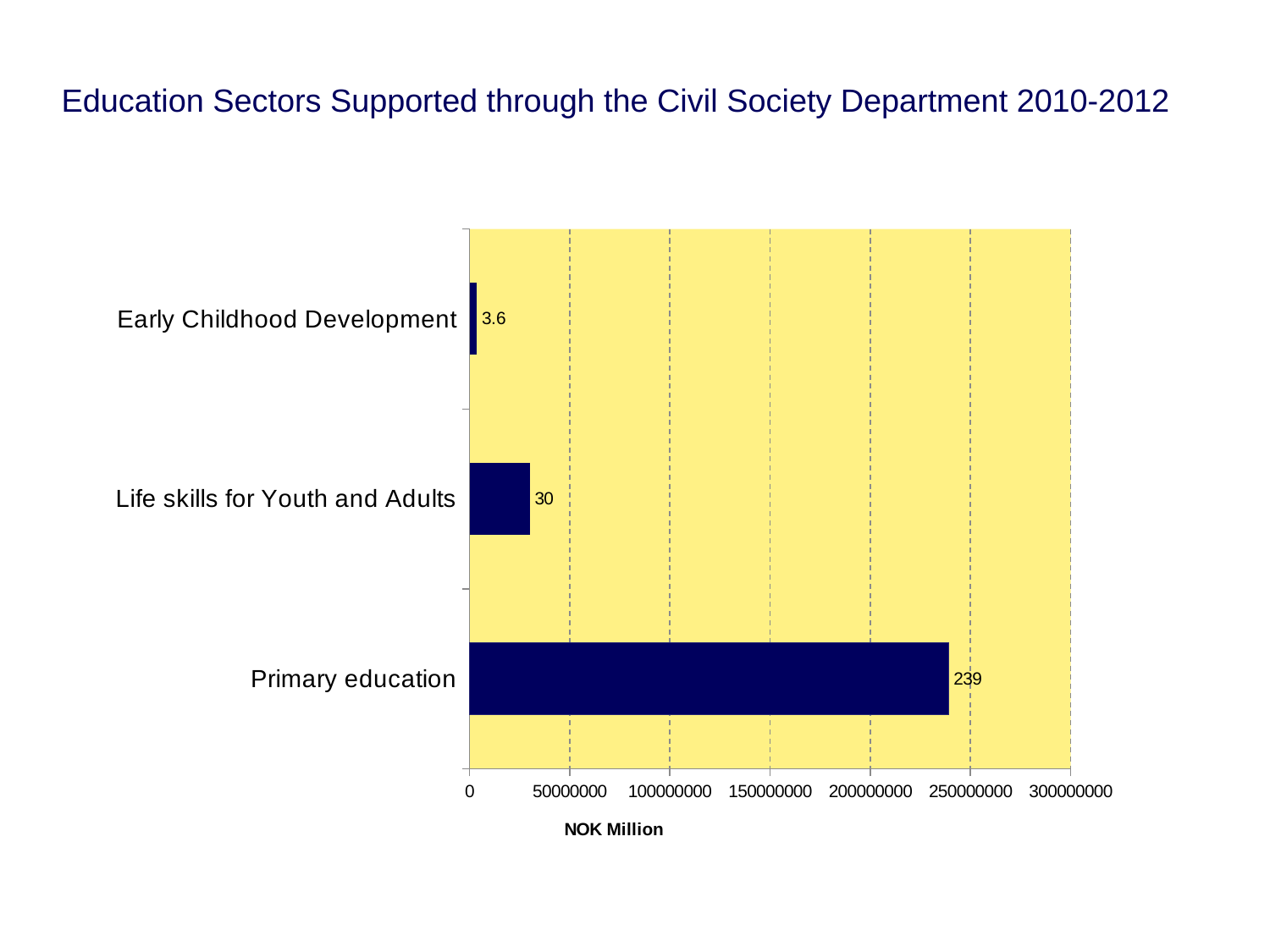
Which education sector has the lowest value? Early Childhood Development How many education sectors are shown in the chart? 3 What is the data label shown for Primary education? 239 Which education sector has the highest value? Primary education What kind of chart is shown on the slide? Bar chart What is the difference between the data labels for Primary education and Life skills for Youth and Adults? 209 What is the difference between the data labels for Life skills for Youth and Adults and Early Childhood Development? 26.4 What is the data label shown for Early Childhood Development? 3.6 What is the title of the horizontal axis? NOK Million What is the data label shown for Life skills for Youth and Adults? 30 Which is larger, the value for Life skills for Youth and Adults or the value for Early Childhood Development? Life skills for Youth and Adults Is the bar for Primary education greater or less than 200000000 on the axis? greater